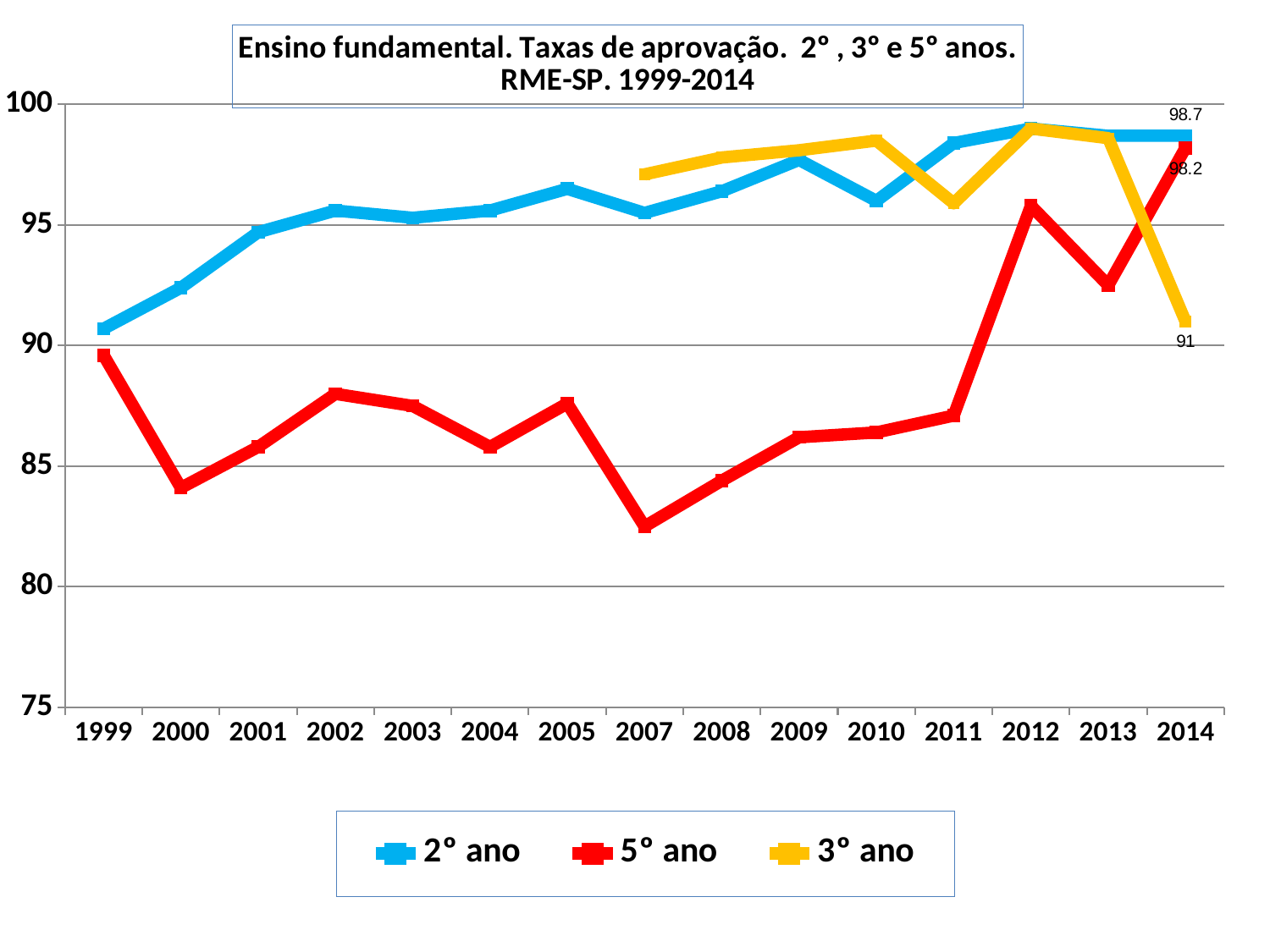
How many years are shown on the x axis? 15 Is the value for 5° ano in 2007 greater or less than 85? less In 2014, which series has the higher value, 2° ano or 3° ano? 2° ano Is the value for 2° ano in 1999 greater or less than 90? greater What is the difference between the 2° ano and 3° ano values in 2014? 7.7 In which year does the 5° ano series reach its lowest value? 2007 What is the value for 2° ano in 2014? 98.7 Which colour represents 5° ano in the legend? red What is the value for 3° ano in 2014? 91 How many series does the legend list? 3 What kind of chart is shown on the slide? line chart What is the value for 5° ano in 2014? 98.2